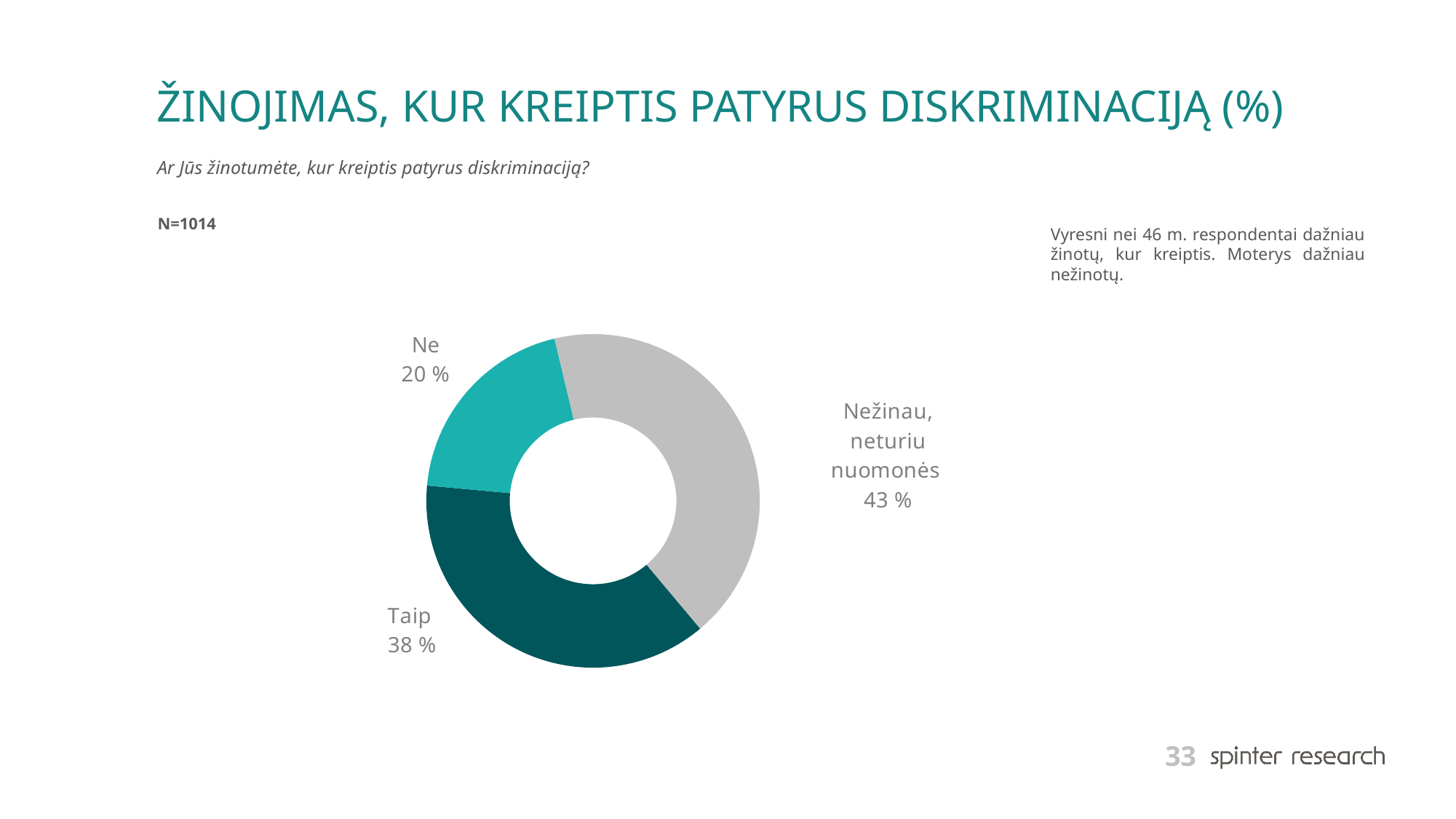
What is the sample size (N) stated on the slide? N=1014 What percentage of respondents answered "Ne"? 20 % Which is larger, the share for "Taip" or the share for "Ne"? Taip What is the difference in percentage points between "Taip" and "Ne"? 18 What percentage of respondents answered "Nežinau, neturiu nuomonės"? 43 % Which response category has the smallest share of the chart? Ne What is the difference in percentage points between "Nežinau, neturiu nuomonės" and "Taip"? 5 How many response categories are shown in the chart? 3 Which response category has the largest share of the chart? Nežinau, neturiu nuomonės What percentage of respondents answered "Taip"? 38 % What colour is the "Taip" segment of the chart? Dark teal What kind of chart is shown on the slide? Doughnut (pie) chart